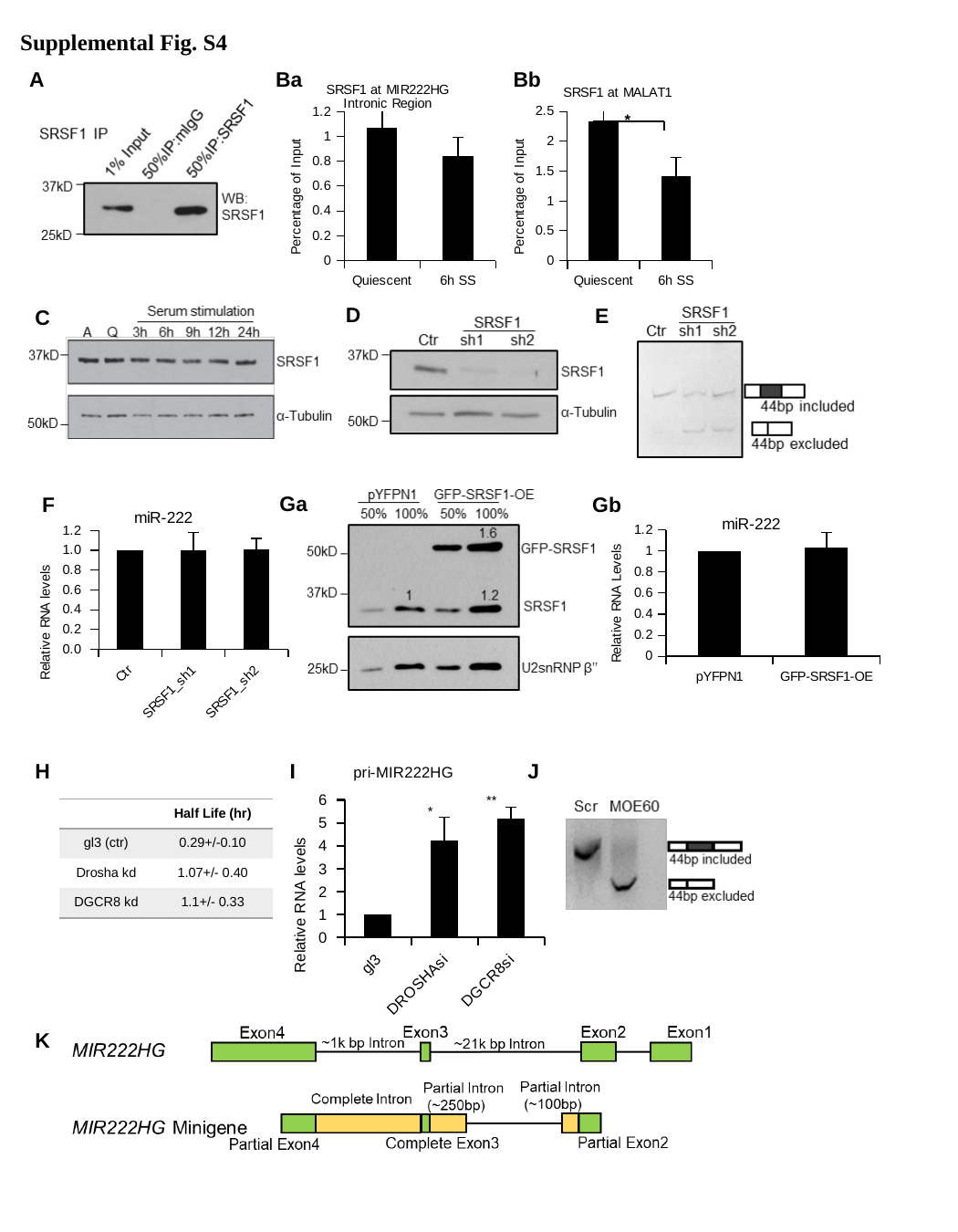
In the chart titled 'SRSF1 at MIR222HG Intronic Region' (panel Ba), how many categories are shown on the x axis? 2 In the chart titled 'pri-MIR222HG' (panel I), is the value for DROSHAsi greater or less than 3? greater In the chart titled 'pri-MIR222HG' (panel I), which category has the highest value? DGCR8si In the chart titled 'SRSF1 at MALAT1' (panel Bb), is the value for 6h SS greater or less than 2? less In the chart titled 'SRSF1 at MIR222HG Intronic Region' (panel Ba), is the value for 6h SS greater or less than 1? less In the miR-222 chart in panel F, what is the relative RNA level for Ctr? 1.0 In the miR-222 chart in panel Gb, what is the relative RNA level for pYFPN1? 1 What kind of chart is the 'pri-MIR222HG' chart in panel I? bar chart In the chart titled 'pri-MIR222HG' (panel I), which category has the lowest value? gl3 In the chart titled 'SRSF1 at MALAT1' (panel Bb), which category has the higher value, Quiescent or 6h SS? Quiescent In the miR-222 chart in panel F, how many categories are shown on the x axis? 3